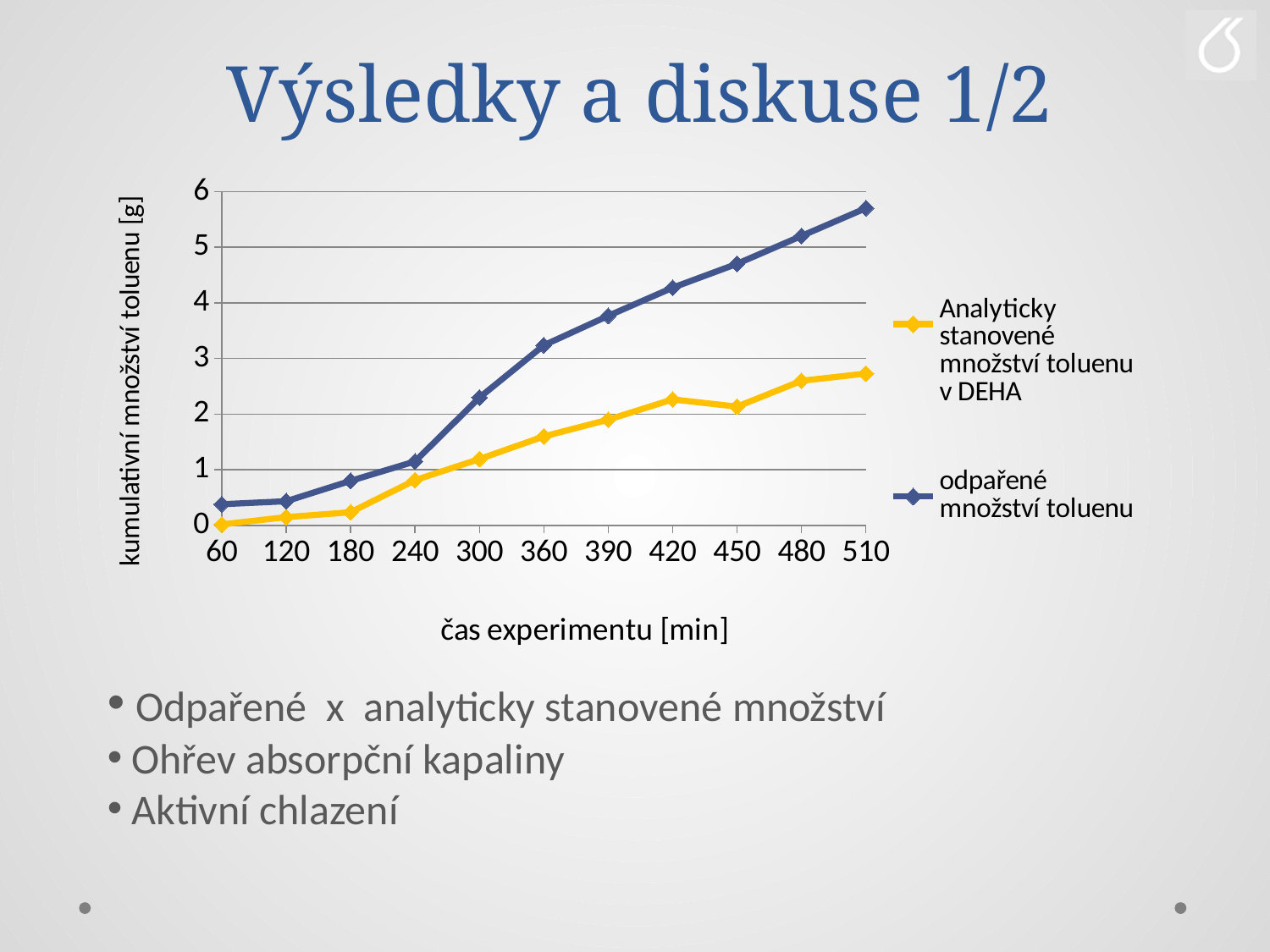
How many time points are plotted along the x axis? 11 At 420 min, which series has the higher value? odpařené množství toluenu Is the value of 'Analyticky stanovené množství toluenu v DEHA' at 510 min greater or less than 3? less What is the label of the x axis? čas experimentu [min] What kind of chart is shown on the slide? line chart Is the value of 'Analyticky stanovené množství toluenu v DEHA' at 240 min greater or less than 1? less What is the label of the y axis? kumulativní množství toluenu [g] How many series does the legend list? 2 At which time does 'odpařené množství toluenu' reach its highest value? 510 Is the value of 'odpařené množství toluenu' at 360 min greater or less than 3? greater Do the values of 'odpařené množství toluenu' rise or fall as time increases? rise